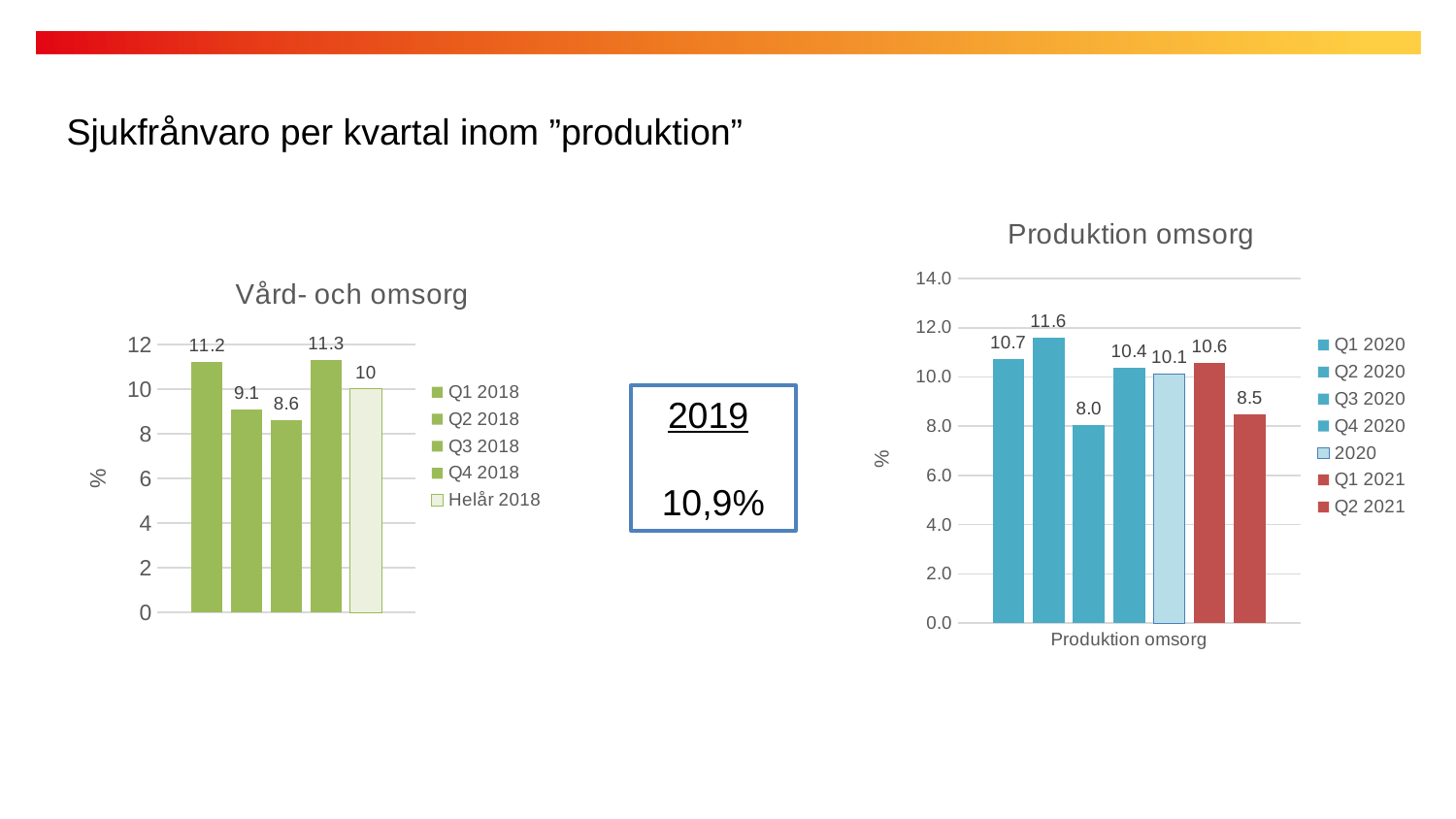
In the "Vård- och omsorg" chart, how many series does the legend list? 5 In the "Produktion omsorg" chart, what is the difference between Q1 2020 and Q2 2021? 2.2 In the "Vård- och omsorg" chart, what is the value for Helår 2018? 10 What kind of chart is the "Produktion omsorg" chart? Bar chart In the "Vård- och omsorg" chart, what is the difference between Q4 2018 and Q2 2018? 2.2 In the "Produktion omsorg" chart, what is the value for Q2 2020? 11.6 In the "Produktion omsorg" chart, how many series does the legend list? 7 In the "Produktion omsorg" chart, which series has the highest value? Q2 2020 In the "Produktion omsorg" chart, what is the value for Q4 2020? 10.4 In the "Produktion omsorg" chart, which is larger, Q1 2021 or Q2 2021? Q1 2021 In the "Vård- och omsorg" chart, which series has the lowest value? Q3 2018 In the "Vård- och omsorg" chart, what is the value for Q1 2018? 11.2